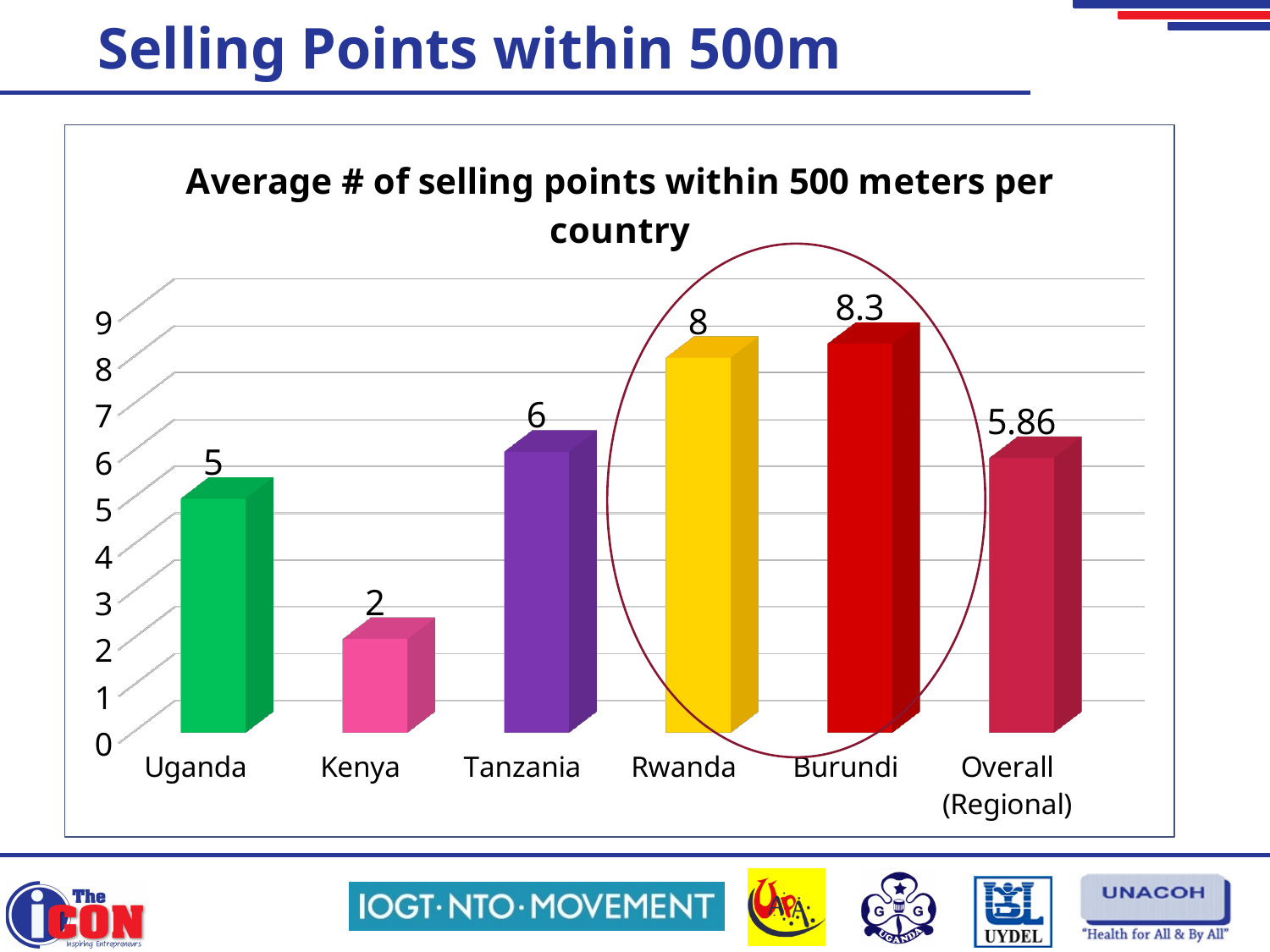
Which country has the highest average number of selling points within 500 meters? Burundi Which has a larger value, Uganda or Tanzania? Tanzania What is the difference between the values for Burundi and Rwanda? 0.3 What is the average number of selling points within 500 meters for Uganda? 5 How many categories are shown on the x axis of the chart? 6 What is the title of the chart? Average # of selling points within 500 meters per country Which country has the lowest average number of selling points within 500 meters? Kenya What is the value shown for Burundi? 8.3 What is the value shown for Overall (Regional)? 5.86 What is the difference between the values for Tanzania and Kenya? 4 What is the value shown for Kenya? 2 What kind of chart is shown on the slide? Bar chart